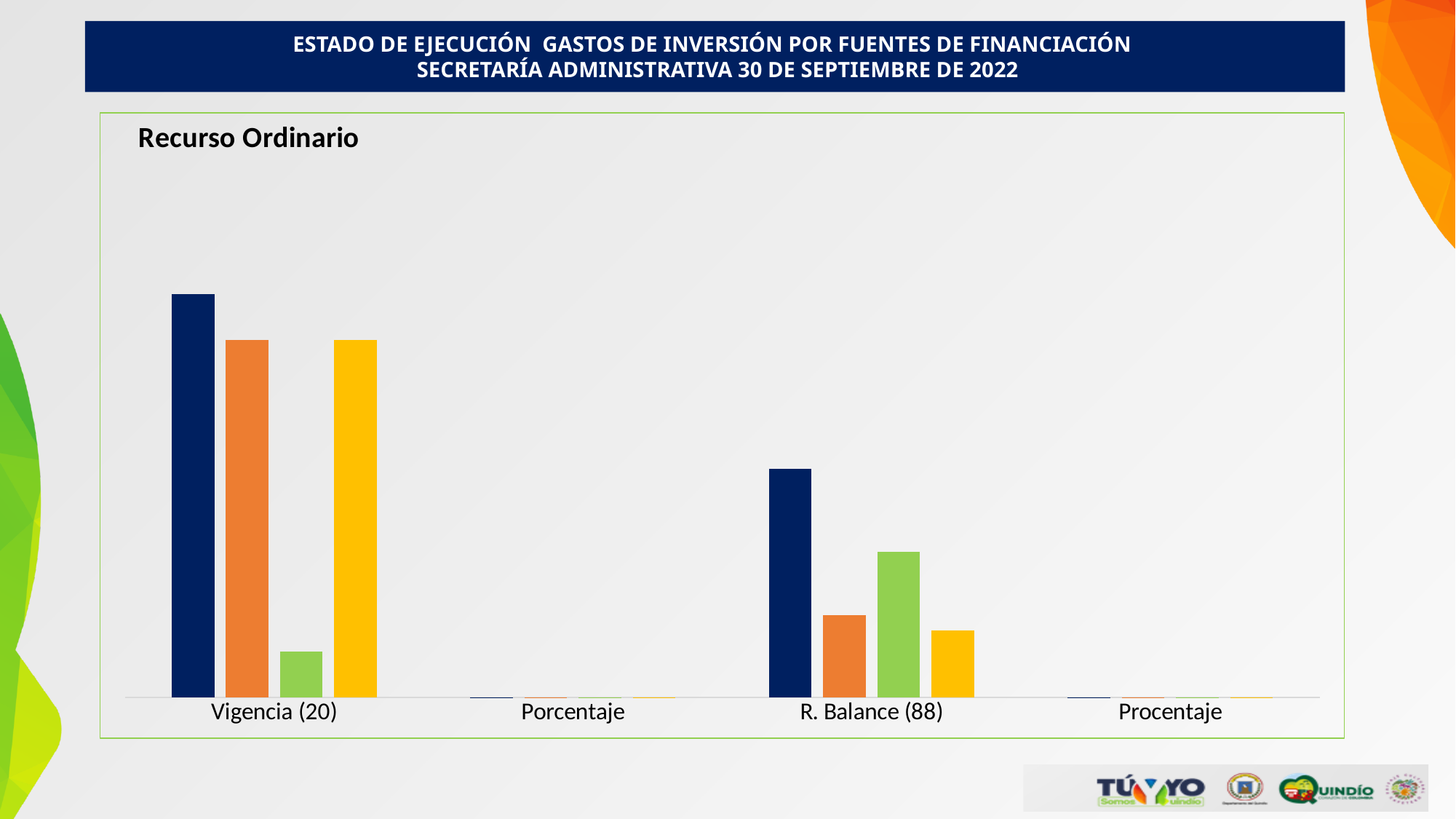
How many bars are plotted for the category Vigencia (20)? 4 Is the green bar taller for Vigencia (20) or for R. Balance (88)? R. Balance (88) Within the category Vigencia (20), which coloured bar is the shortest? the green bar Which colours are used for the four bars in each category of the chart? dark blue, orange, green and yellow What is the title of the chart? Recurso Ordinario What kind of chart is shown on the slide? bar chart Within the category R. Balance (88), which coloured bar is the tallest? the dark blue bar Is the orange bar taller for Vigencia (20) or for R. Balance (88)? Vigencia (20) Which category has the tallest bar in the chart? Vigencia (20) Is the yellow bar taller for Vigencia (20) or for R. Balance (88)? Vigencia (20) How many categories are shown on the x axis of the chart? 4